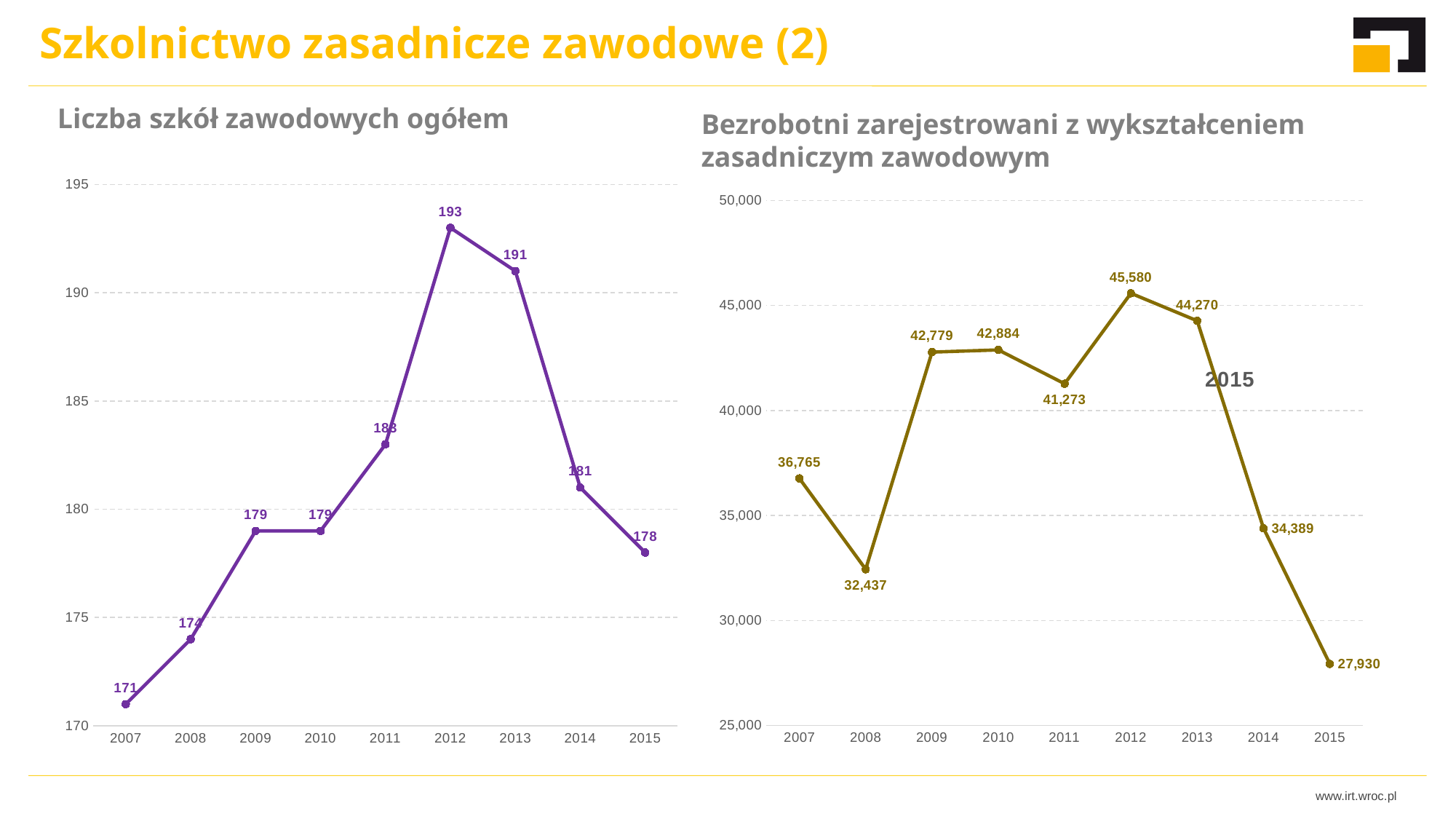
In the chart 'Liczba szkół zawodowych ogółem', what is the difference between the values for 2012 and 2015? 15 In the chart 'Liczba szkół zawodowych ogółem', how many data points are plotted? 9 In the chart 'Liczba szkół zawodowych ogółem', what is the value for 2012? 193 What type of chart is 'Liczba szkół zawodowych ogółem'? line chart In the chart 'Liczba szkół zawodowych ogółem', which year has the lowest value? 2007 In the chart 'Liczba szkół zawodowych ogółem', is the value for 2011 greater or less than 180? greater In the chart 'Bezrobotni zarejestrowani z wykształceniem zasadniczym zawodowym', which year has the lowest value? 2015 In the chart 'Bezrobotni zarejestrowani z wykształceniem zasadniczym zawodowym', what is the value for 2008? 32,437 In the chart 'Bezrobotni zarejestrowani z wykształceniem zasadniczym zawodowym', do the values rise or fall from 2012 to 2015? fall In the chart 'Bezrobotni zarejestrowani z wykształceniem zasadniczym zawodowym', is the value for 2009 larger than the value for 2010? No, 2010 is larger In the chart 'Bezrobotni zarejestrowani z wykształceniem zasadniczym zawodowym', what is the difference between the values for 2014 and 2015? 6,459 In the chart 'Bezrobotni zarejestrowani z wykształceniem zasadniczym zawodowym', which year has the highest value? 2012